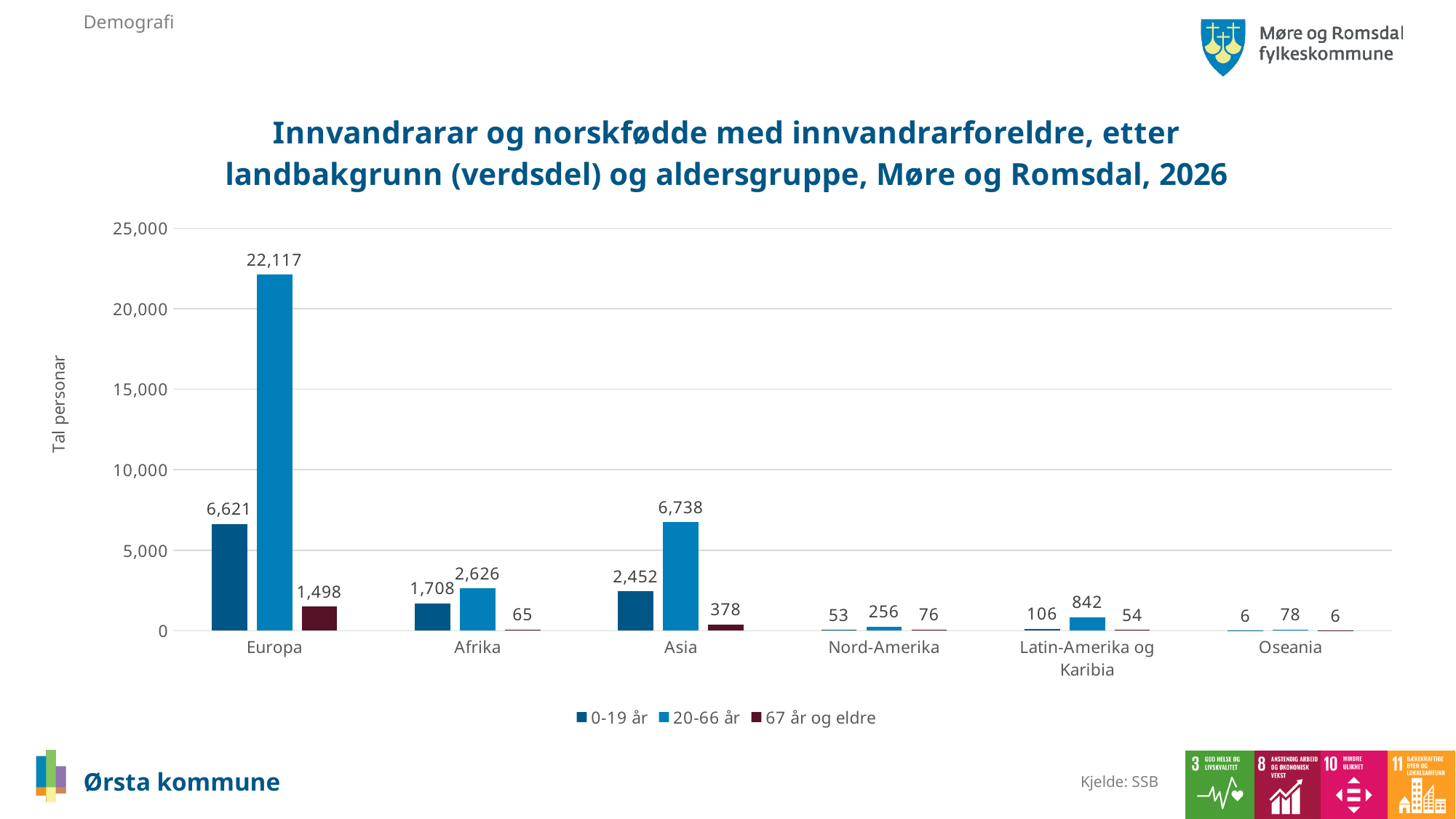
What kind of chart is shown on the slide? bar chart Which is larger for Afrika: the 0-19 år value or the 20-66 år value? 20-66 år What is the value for Europa in the 20-66 år series? 22,117 Which category has the highest value in the 20-66 år series? Europa What is the difference between the 20-66 år value and the 0-19 år value for Asia? 4,286 What is the value for Asia in the 0-19 år series? 2,452 What is the label of the y axis? Tal personar What is the value for Latin-Amerika og Karibia in the 67 år og eldre series? 54 How many series does the legend list? 3 Is the value for Europa in the 0-19 år series greater or less than 5,000? greater Which category has the lowest value in the 0-19 år series? Oseania How many categories are shown on the x axis? 6